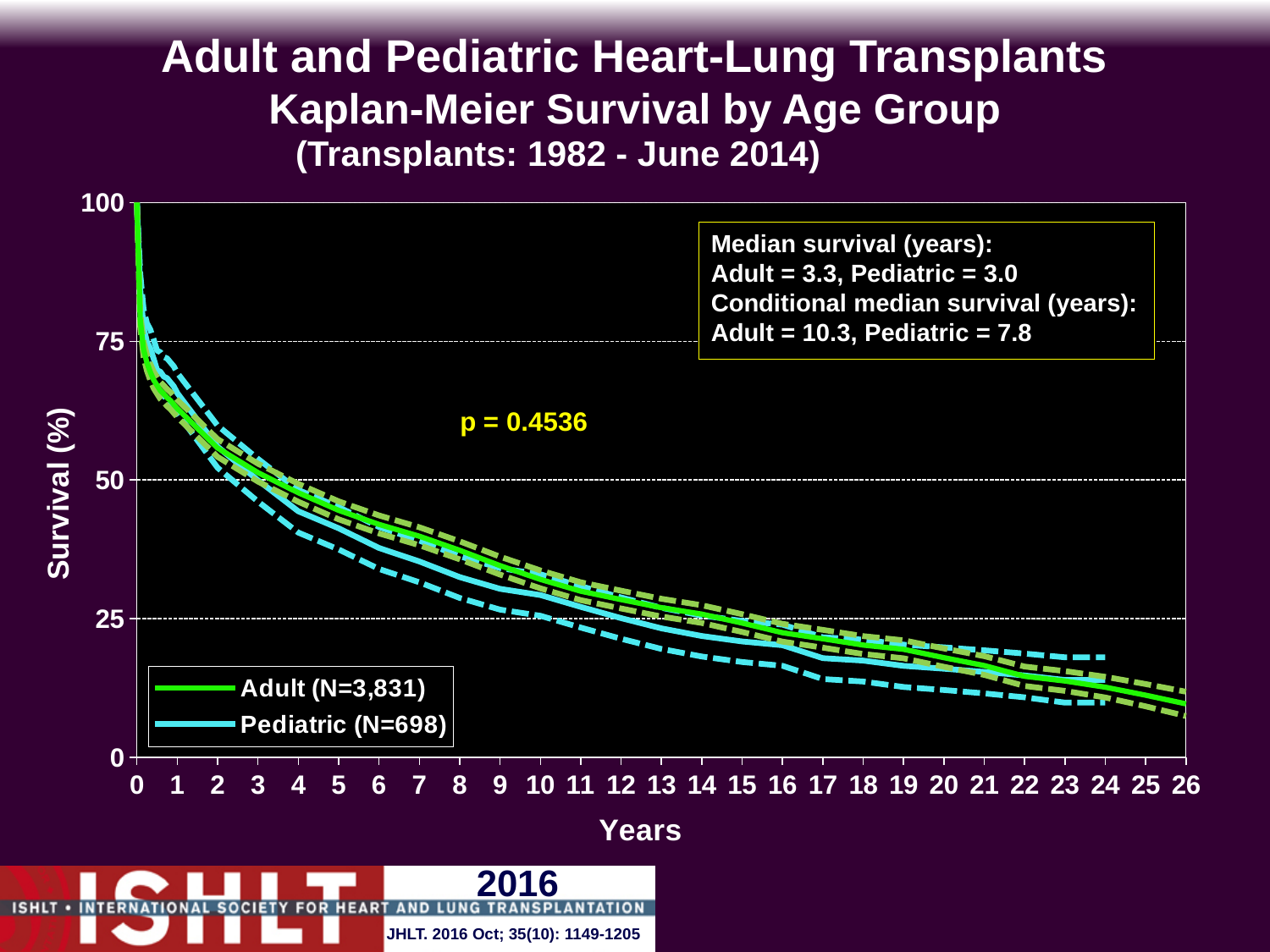
What is the median survival in years for the Adult group? 3.3 Is the Pediatric survival at 15 years greater or less than 25%? less What kind of chart is shown on the slide? Line chart What is the difference in median survival (years) between the Adult and Pediatric groups? 0.3 What is the difference in conditional median survival (years) between the Adult and Pediatric groups? 2.5 Do the survival curves rise or fall as years increase? Fall How many series does the legend list? 2 Is the Adult survival at 5 years greater or less than 50%? less What is the conditional median survival in years for the Pediatric group? 7.8 Which group has the higher conditional median survival, Adult or Pediatric? Adult What p-value is printed on the chart? p = 0.4536 What is the number of patients (N) in the Pediatric group? 698